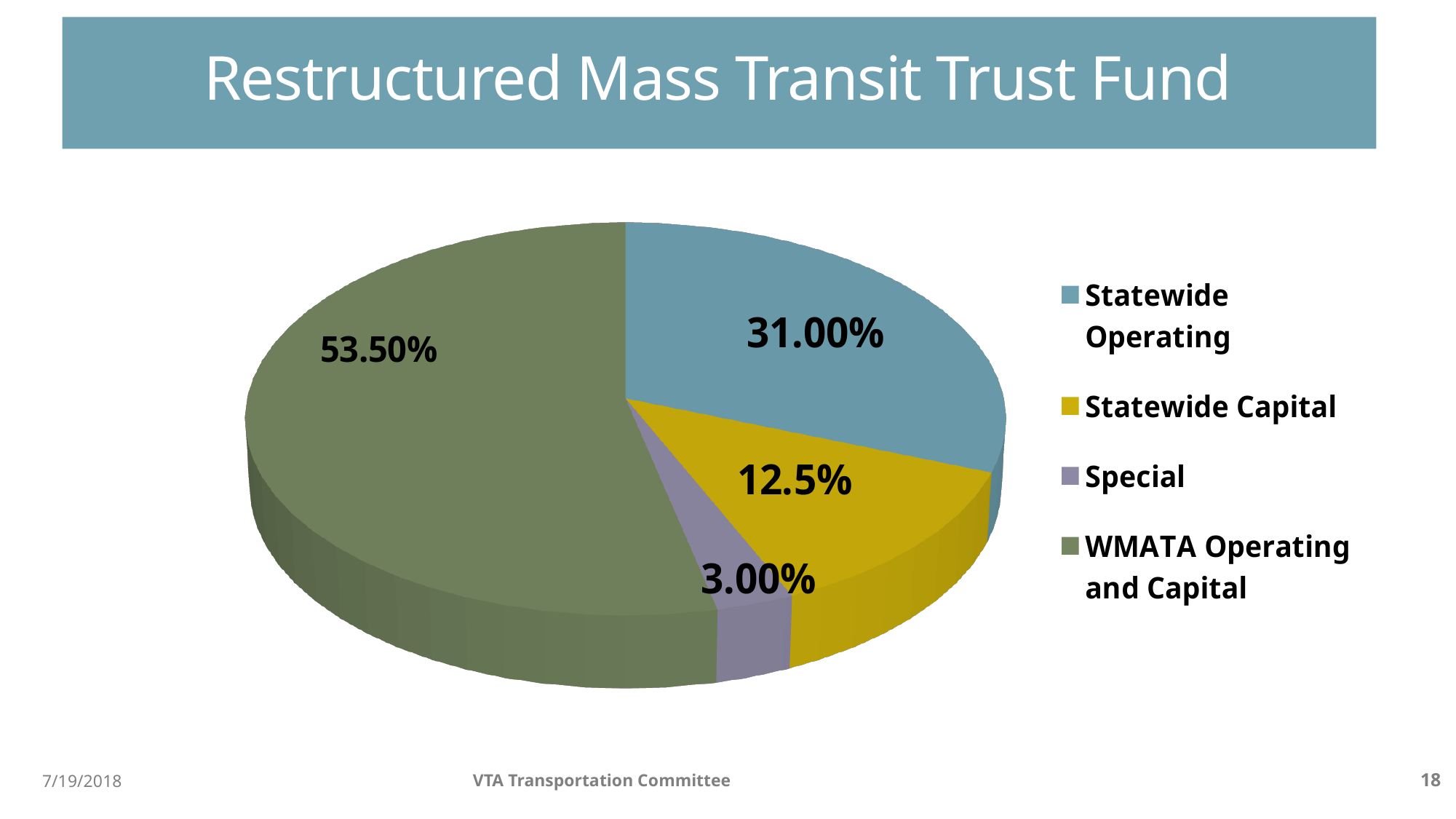
What kind of chart is shown on the slide? pie chart What share of the fund goes to Statewide Capital? 12.5% What is the title of the slide containing the pie chart? Restructured Mass Transit Trust Fund What share of the Restructured Mass Transit Trust Fund goes to Statewide Operating? 31.00% How many categories does the pie chart show? 4 Which category has the smallest share of the fund? Special What share of the fund goes to Special? 3.00% Which category has the largest share of the fund? WMATA Operating and Capital What is the difference between the WMATA Operating and Capital share and the Statewide Operating share? 22.50% Which is larger, the share for Statewide Operating or the share for Statewide Capital? Statewide Operating What is the combined share of Statewide Capital and Special? 15.5% What share of the fund goes to WMATA Operating and Capital? 53.50%